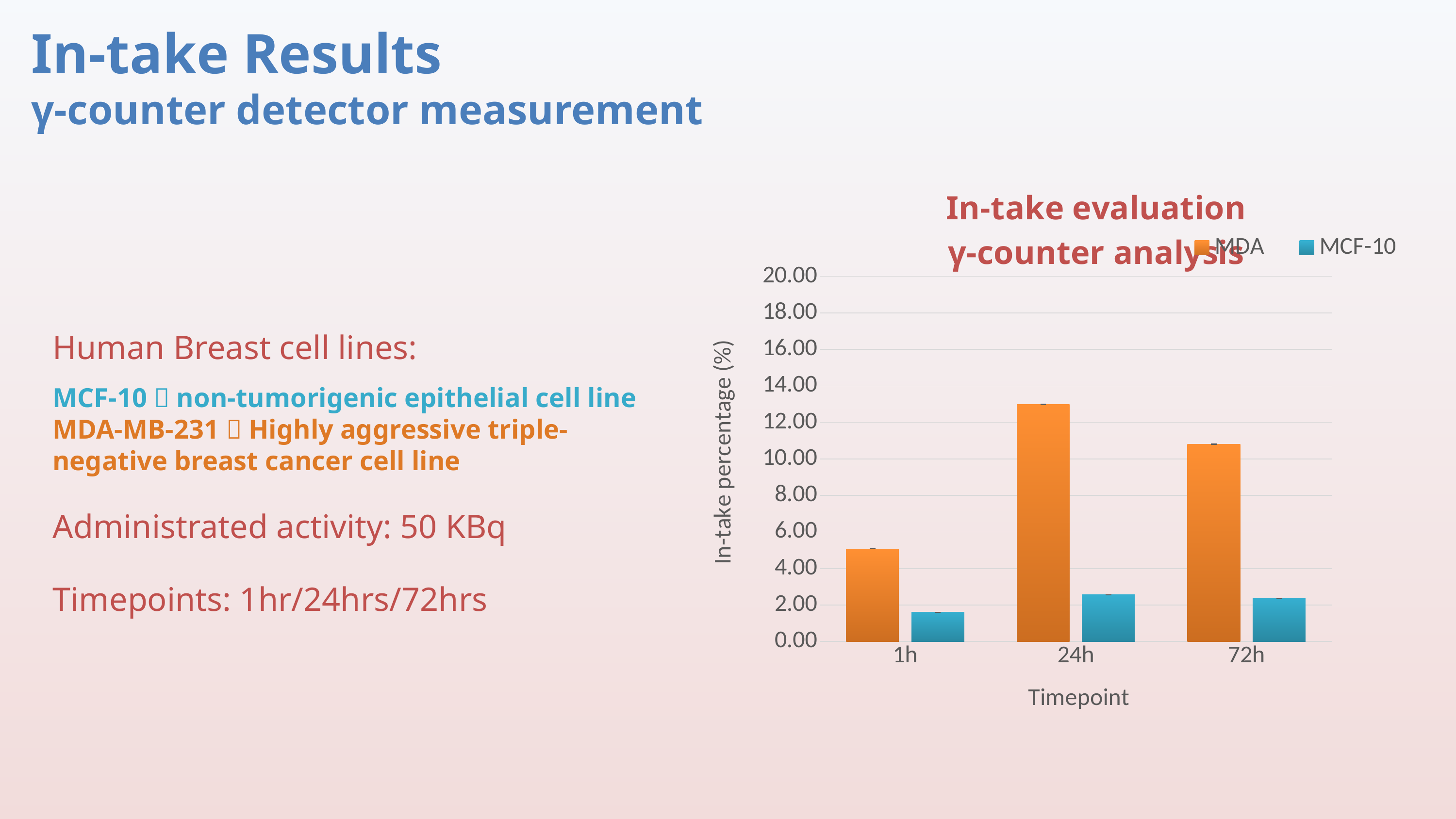
What is the label of the y axis of the chart? In-take percentage (%) Is the MDA value at 24h greater or less than 12.00? greater Is the MCF-10 value at 1h greater or less than 2.00? less How many timepoints are shown on the x axis of the chart? 3 Which series is shown in orange in the chart? MDA At which timepoint is the MDA in-take percentage lowest? 1h Is the MDA value at 1h greater or less than 6.00? less What kind of chart is shown on the slide? bar chart How many series does the chart legend list? 2 At which timepoint is the MDA in-take percentage highest? 24h At 24h, which series has the larger in-take percentage, MDA or MCF-10? MDA At which timepoint is the MCF-10 in-take percentage lowest? 1h